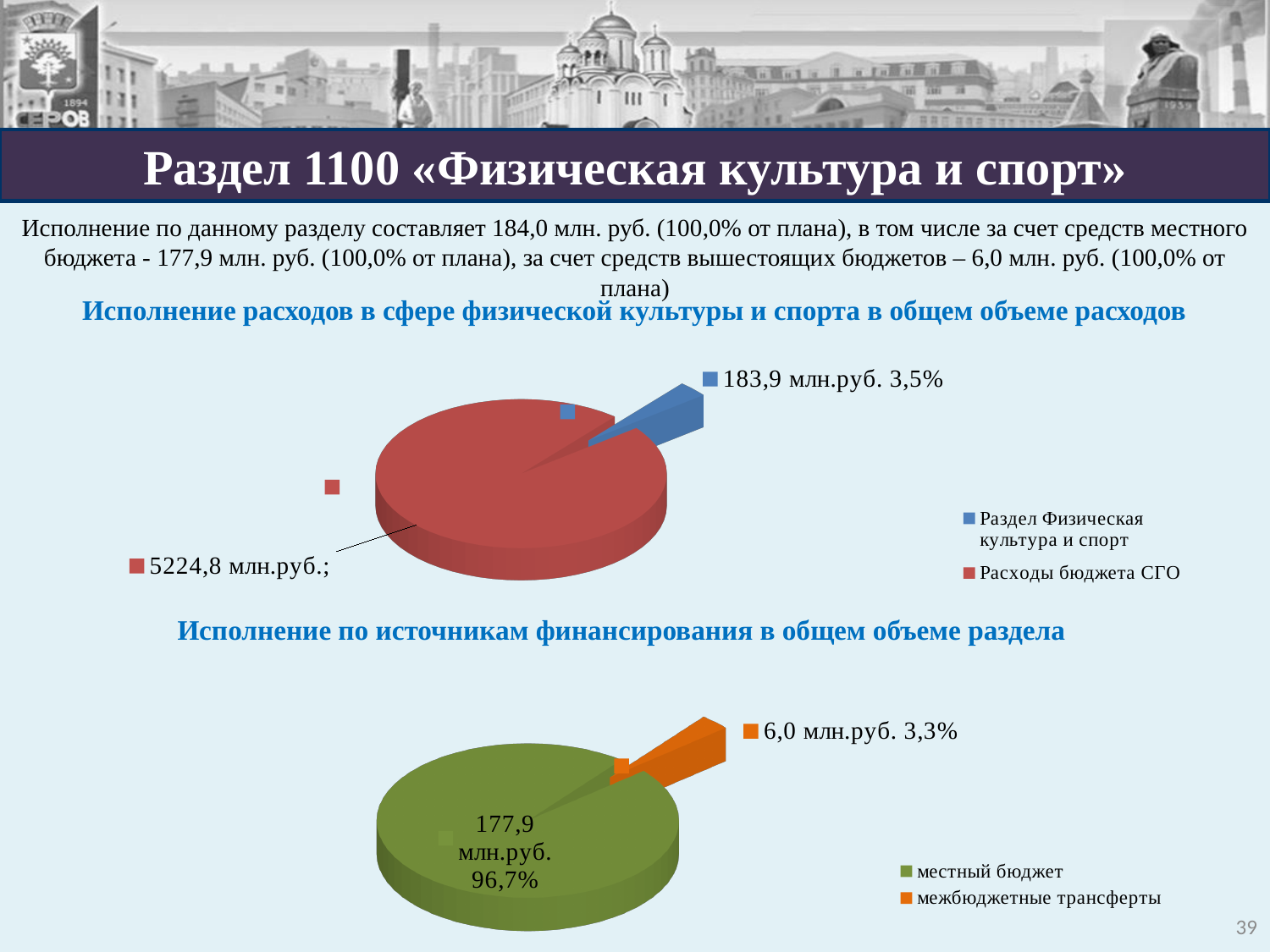
In the bottom pie chart, what value is shown for «межбюджетные трансферты»? 6,0 млн.руб. In the bottom pie chart, what share does «местный бюджет» represent? 96,7% How many entries does the legend of the top pie chart list? 2 In the bottom pie chart, which slice is the smallest? межбюджетные трансферты In the bottom pie chart, what share does «межбюджетные трансферты» represent? 3,3% In the top pie chart, what share of the total does «Раздел Физическая культура и спорт» represent? 3,5% What kind of chart is used under the title «Исполнение расходов в сфере физической культуры и спорта в общем объеме расходов»? Pie chart In the top pie chart, what value is shown for «Расходы бюджета СГО»? 5224,8 млн.руб. In the top pie chart, which slice is larger: «Раздел Физическая культура и спорт» or «Расходы бюджета СГО»? Расходы бюджета СГО In the top pie chart, what value is shown for «Раздел Физическая культура и спорт»? 183,9 млн.руб. In the bottom pie chart, what colour is the «местный бюджет» slice? Green In the bottom pie chart «Исполнение по источникам финансирования в общем объеме раздела», what value is shown for «местный бюджет»? 177,9 млн.руб.